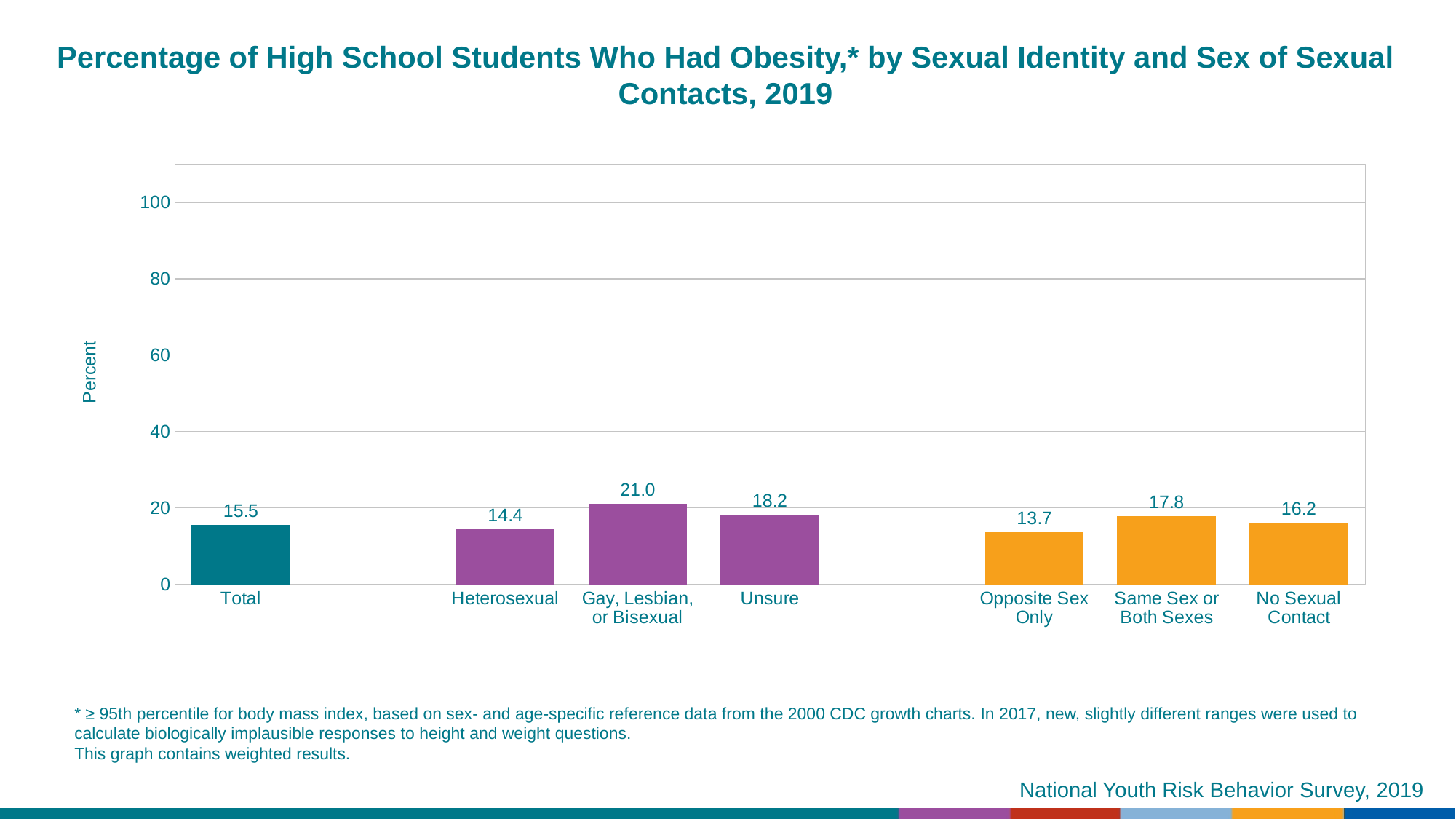
How many categories are shown on the x axis? 7 What is the difference between the values for Same Sex or Both Sexes and No Sexual Contact? 1.6 Which is larger, the value for Same Sex or Both Sexes or the value for Opposite Sex Only? Same Sex or Both Sexes What is the value for Gay, Lesbian, or Bisexual students? 21.0 What is the label of the y axis? Percent Which category has the lowest percentage of students who had obesity? Opposite Sex Only What is the percentage of high school students who had obesity in the Total category? 15.5 Which category has the highest percentage of students who had obesity? Gay, Lesbian, or Bisexual Is the value for Unsure greater or less than 20? less What is the difference between the values for Gay, Lesbian, or Bisexual and Heterosexual students? 6.6 What kind of chart is shown on the slide? bar chart What is the value for students with No Sexual Contact? 16.2